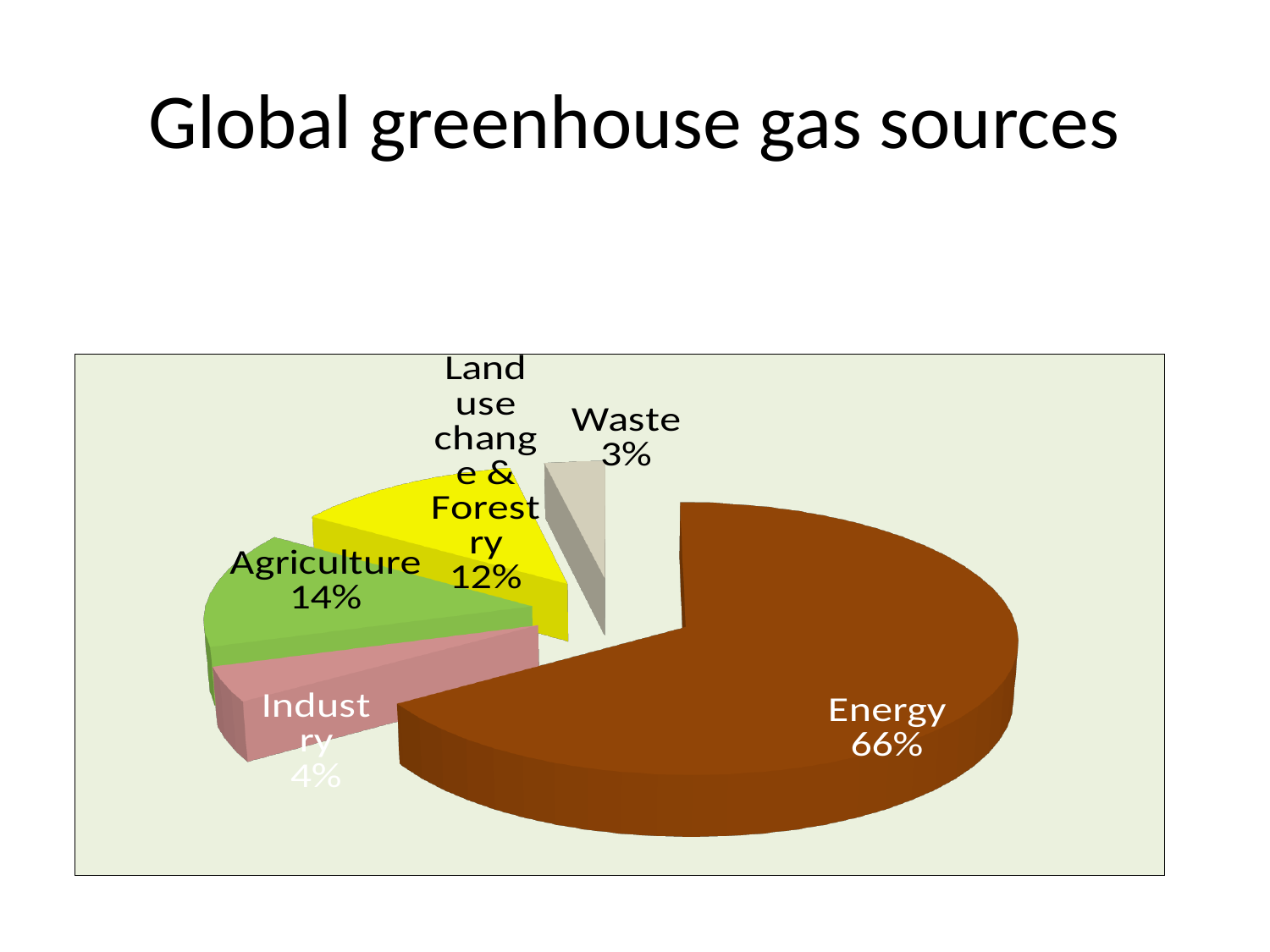
How many slices does the pie chart have? 5 Which is larger, the share for Agriculture or the share for Land use change & Forestry? Agriculture What kind of chart is shown on the slide? Pie chart What is the difference in percentage points between Energy and Agriculture? 52 What share of global greenhouse gas sources does Energy account for? 66% Which source has the smallest share of the pie? Waste What percentage is shown for Waste? 3% What percentage is shown for Land use change & Forestry? 12% What is the title of the slide containing the chart? Global greenhouse gas sources What percentage is shown for Agriculture? 14% What percentage is shown for Industry? 4% Which source has the largest share of the pie? Energy